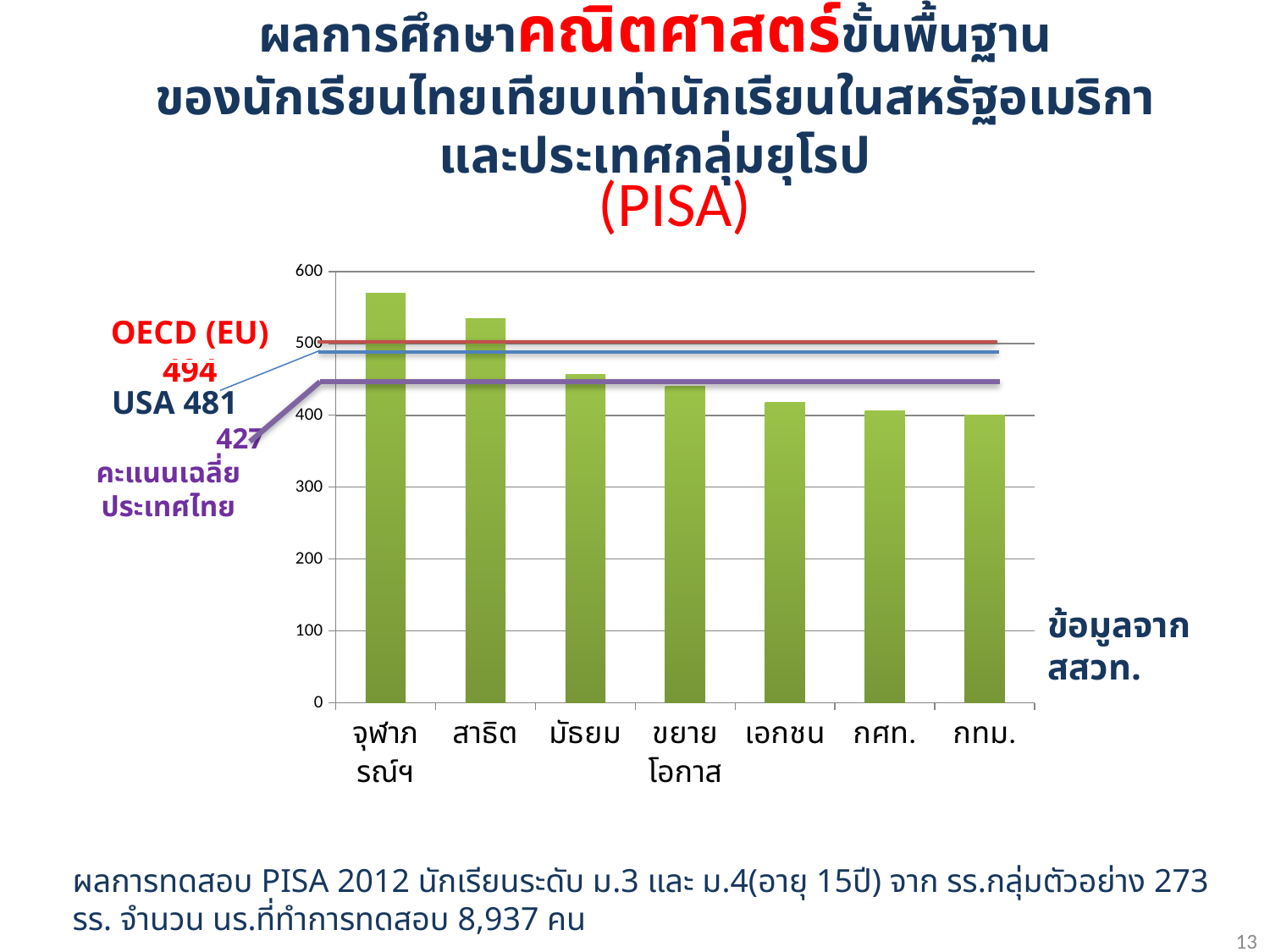
Is the value for สาธิต greater or less than 500? greater How many school-group categories are plotted on the x axis? 7 Is the value for เอกชน greater or less than 500? less What OECD (EU) score is marked by the red reference line? 494 Which category has the highest bar? จุฬาภรณ์ฯ Is the value for จุฬาภรณ์ฯ greater or less than 500? greater Which category has the lowest bar? กทม. What kind of chart is shown on the slide? bar chart What USA score is marked by the blue reference line? 481 Do the bar values rise or fall from left to right along the x axis? fall Which is larger, the value for จุฬาภรณ์ฯ or the value for กทม.? จุฬาภรณ์ฯ